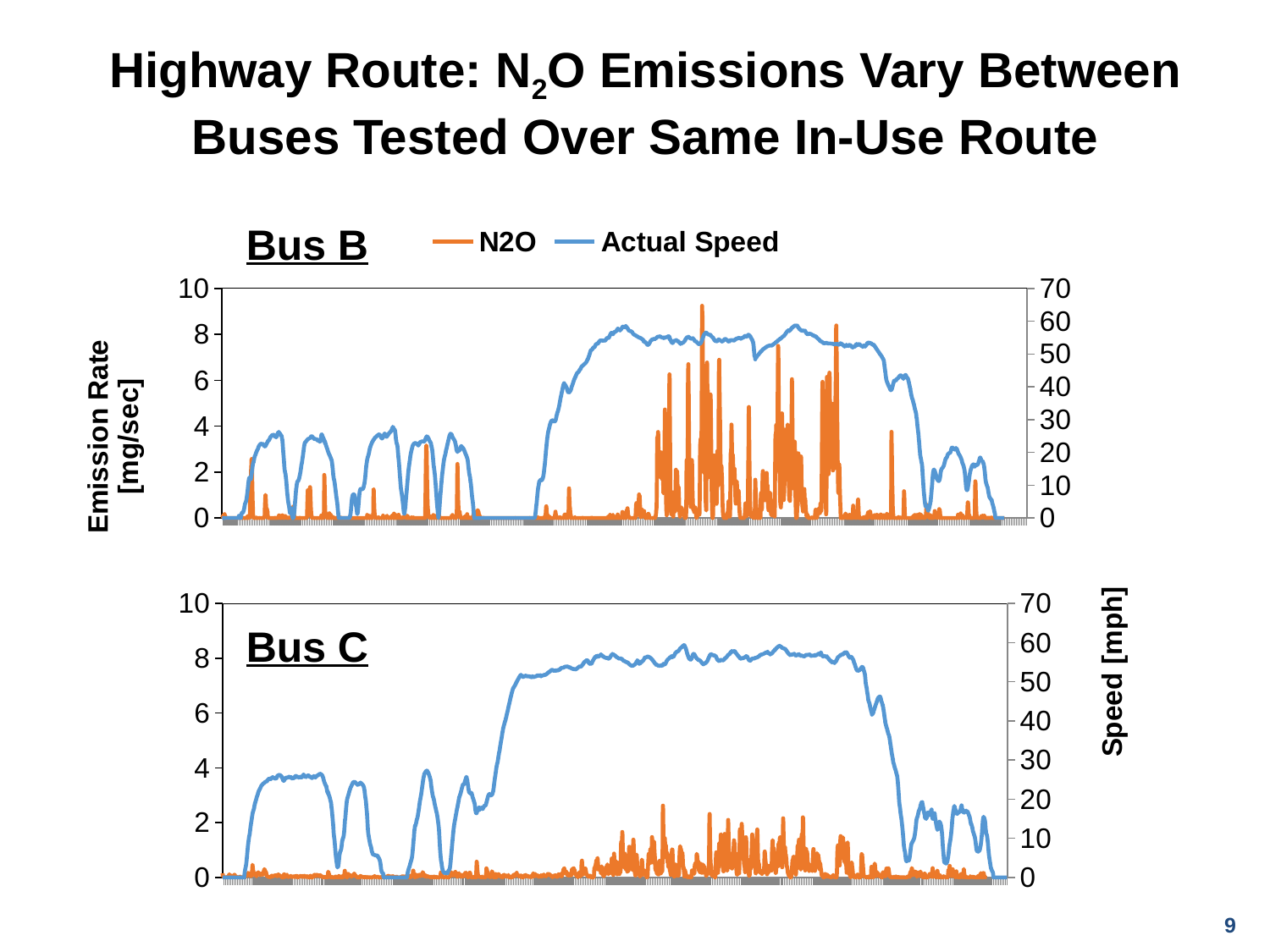
How many series does the legend list for the Bus B chart? 2 What kind of chart is the Bus B chart? line chart In the Bus C chart, is the highest N2O emission rate peak greater or less than 4 mg/sec? less What is the highest value shown on the left (Emission Rate) axis of the Bus C chart? 10 In the Bus B chart, is the highest N2O emission rate peak greater or less than 8 mg/sec? greater Which bus shows the higher peak N2O emission rate, Bus B or Bus C? Bus B In the Bus C chart, is the maximum Actual Speed greater or less than 50 mph? greater What is the highest value shown on the right (Speed) axis of the Bus B chart? 70 In the Bus B chart, which colour is used for the Actual Speed series? blue What kind of chart is the Bus C chart? line chart What are the two series named in the legend above the Bus B chart? N2O and Actual Speed